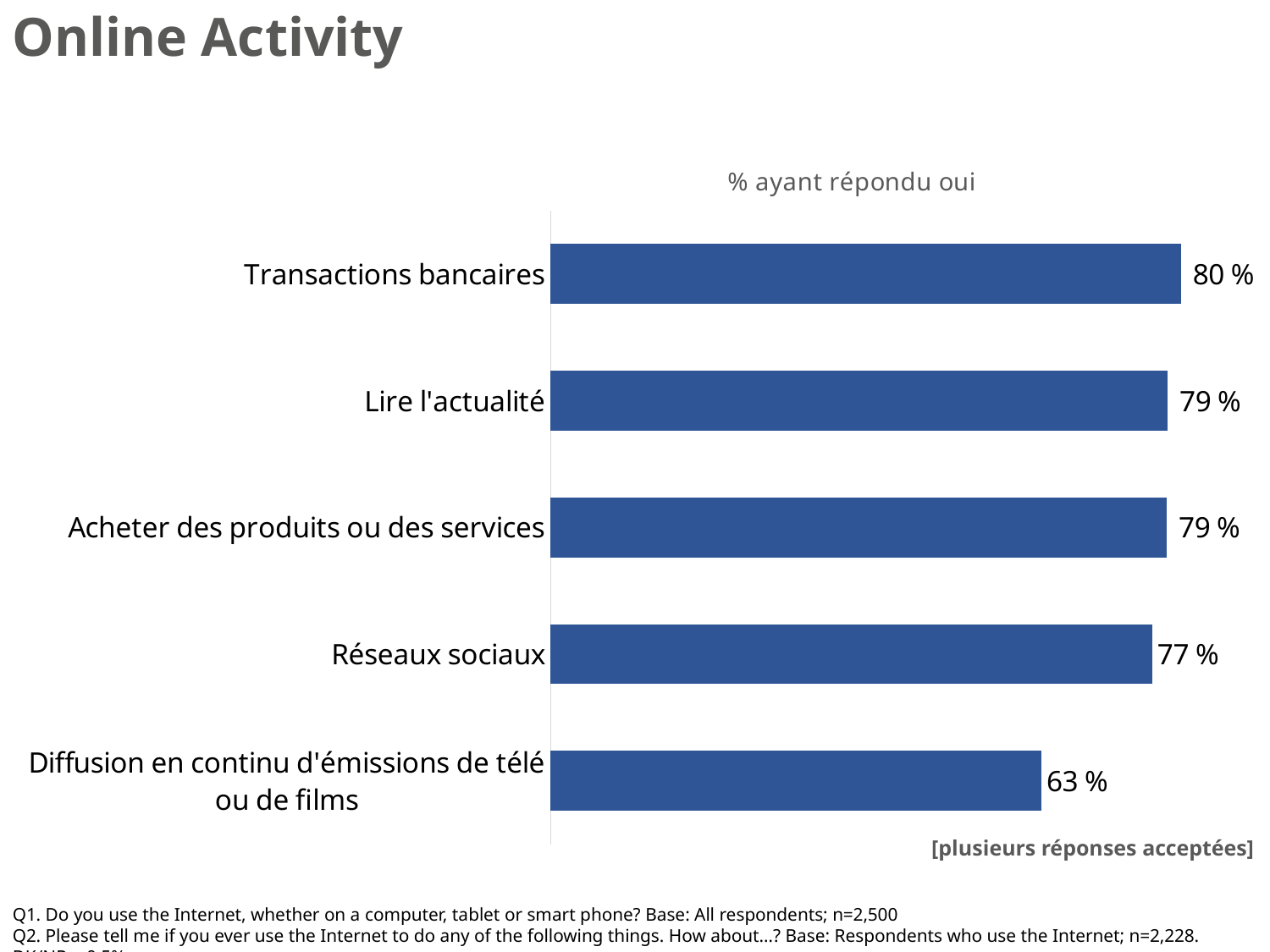
What kind of chart is shown on the slide? Bar chart Which is larger, the value for Réseaux sociaux or the value for Diffusion en continu d'émissions de télé ou de films? Réseaux sociaux What percentage of respondents said yes to Transactions bancaires? 80 % How many activities are shown in the chart? 5 What is the difference between Acheter des produits ou des services and Réseaux sociaux? 2 What percentage is shown for Diffusion en continu d'émissions de télé ou de films? 63 % What is the difference in percentage points between Transactions bancaires and Diffusion en continu d'émissions de télé ou de films? 17 Which activity has the highest percentage? Transactions bancaires What is the subtitle shown above the chart? % ayant répondu oui What is the value shown for Réseaux sociaux? 77 % Which activity has the lowest percentage? Diffusion en continu d'émissions de télé ou de films What is the value for Lire l'actualité? 79 %